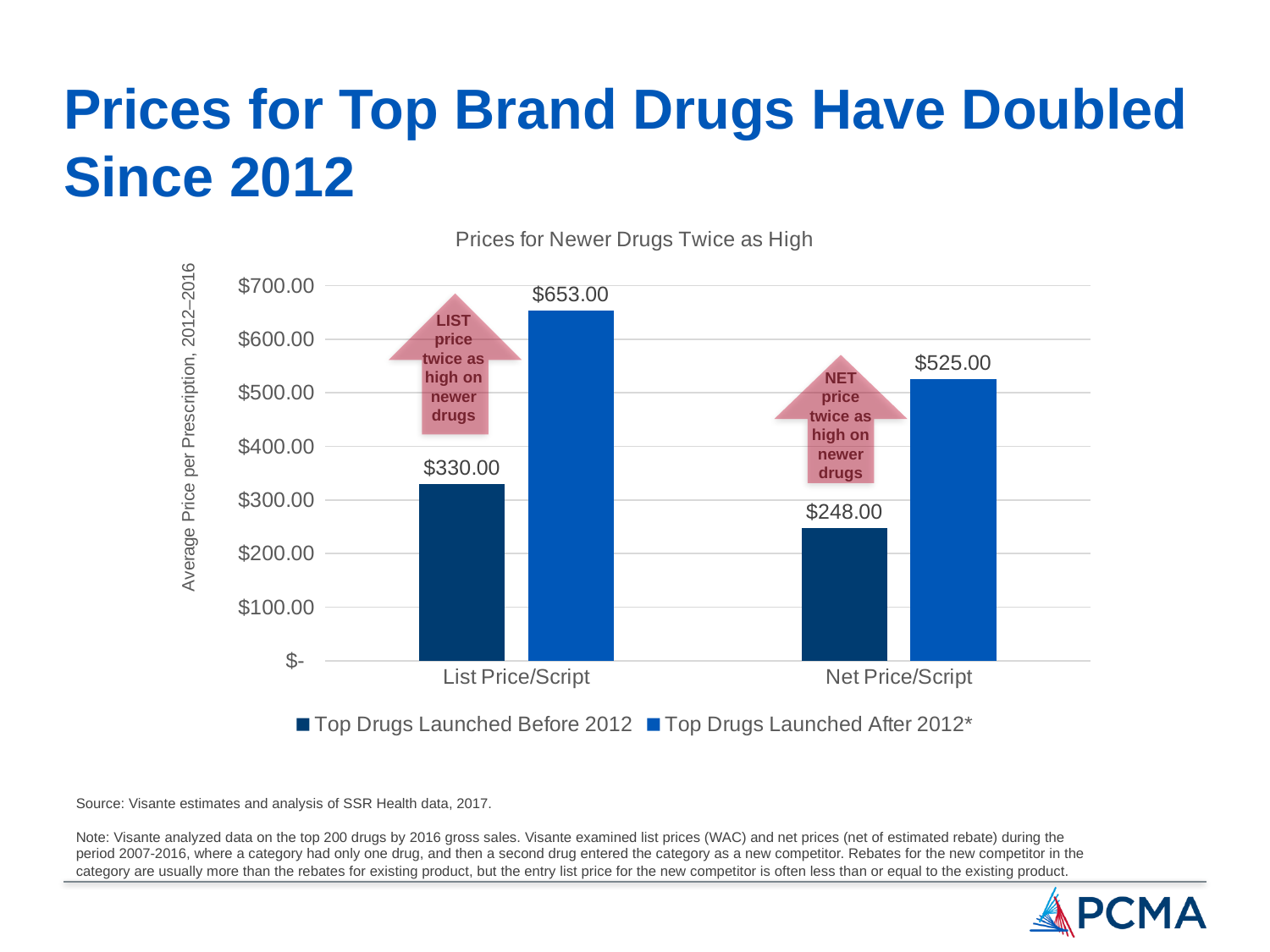
Which bar in the chart has the lowest value? Top Drugs Launched Before 2012, Net Price/Script What is the list price per script for Top Drugs Launched After 2012*? $653.00 What is the net price per script for Top Drugs Launched Before 2012? $248.00 Which bar in the chart has the highest value? Top Drugs Launched After 2012*, List Price/Script What is the title of the chart? Prices for Newer Drugs Twice as High What is the difference between the net price per script for drugs launched after 2012 and those launched before 2012? $277.00 What is the list price per script for Top Drugs Launched Before 2012? $330.00 What is the difference between the list price per script for drugs launched after 2012 and those launched before 2012? $323.00 What is the net price per script for Top Drugs Launched After 2012*? $525.00 For Net Price/Script, which series has the larger value: Top Drugs Launched Before 2012 or Top Drugs Launched After 2012*? Top Drugs Launched After 2012* What kind of chart is shown on the slide? Bar chart How many series does the legend list? 2